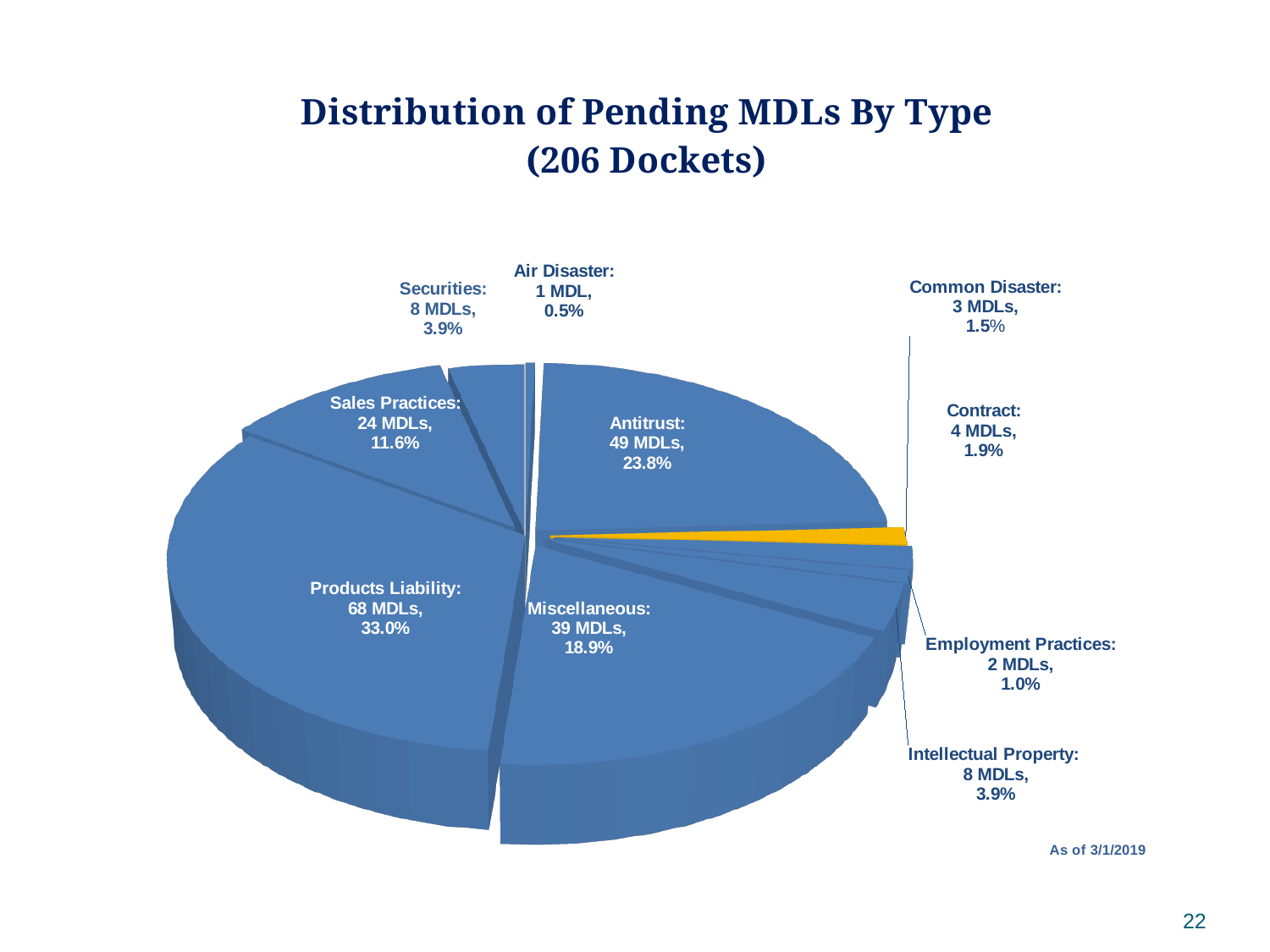
What kind of chart is shown on the slide? Pie chart What share of pending MDLs is Products Liability? 33.0% How many more MDLs does Products Liability have than Miscellaneous? 29 Which has more pending MDLs, Sales Practices or Contract? Sales Practices How many MDLs are in the Antitrust category? 49 MDLs How many MDLs are in the Employment Practices category? 2 MDLs What is the title of the chart? Distribution of Pending MDLs By Type (206 Dockets) How many categories are shown in the pie chart? 10 What percentage of pending MDLs is Miscellaneous? 18.9% Which category has the largest number of pending MDLs? Products Liability As of what date is the chart data reported? 3/1/2019 Which category has the smallest number of pending MDLs? Air Disaster